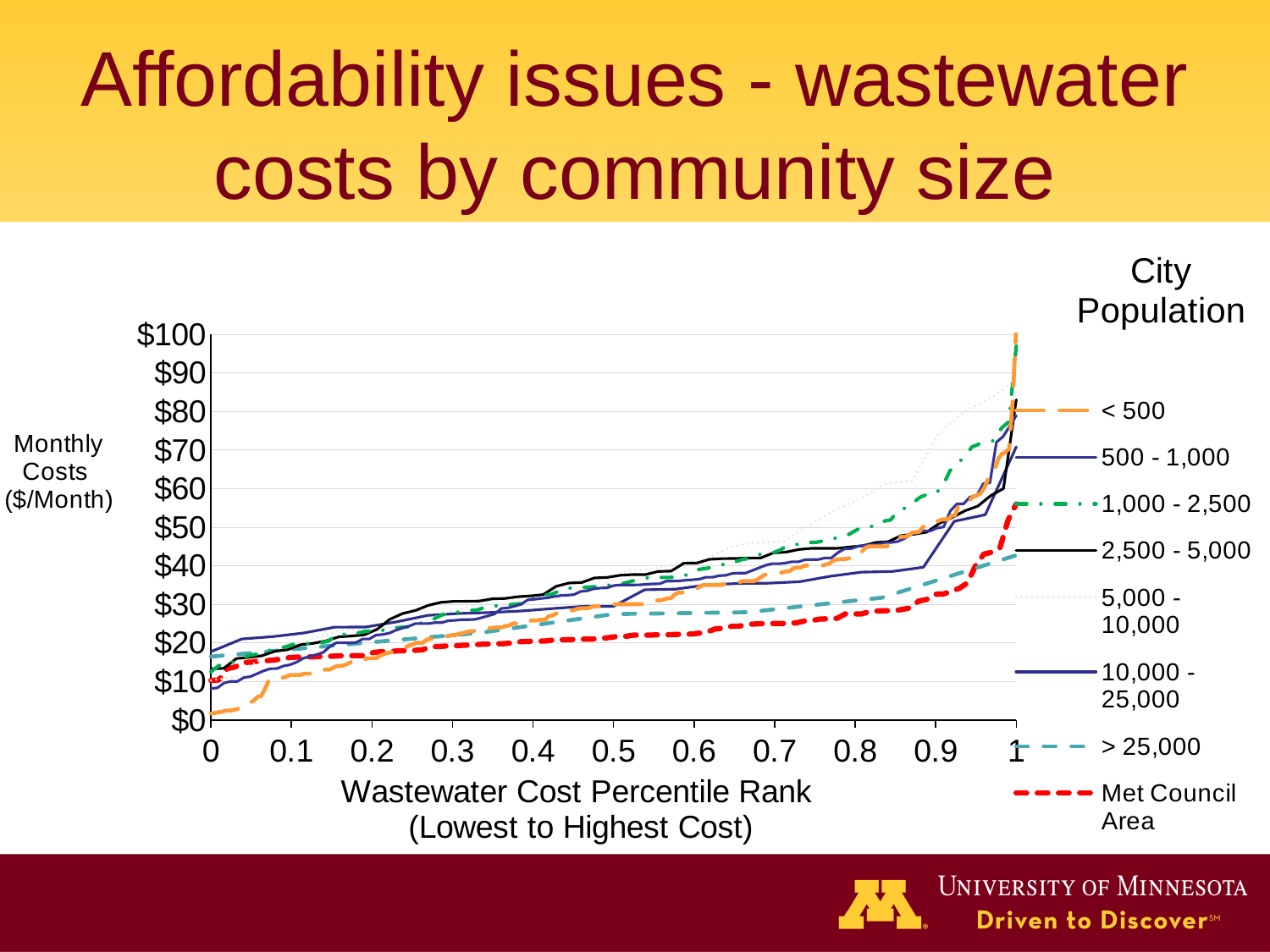
Do the lines rise or fall as the percentile rank increases along the x axis? rise At percentile rank 0.5, which is larger: the Met Council Area or the 2,500 - 5,000 series? 2,500 - 5,000 Is the value for the Met Council Area at percentile rank 0.5 greater or less than $30? less How many series does the legend list? 8 At percentile rank 0.9, which is larger: the 1,000 - 2,500 series or the Met Council Area? 1,000 - 2,500 What kind of chart is shown on the slide? line chart Is the value for the 2,500 - 5,000 series at percentile rank 0.3 greater or less than $20? greater Is the value for the > 25,000 series at percentile rank 0.9 greater or less than $50? less Which series has the lowest value at percentile rank 0.5? Met Council Area What is the label of the x axis? Wastewater Cost Percentile Rank (Lowest to Highest Cost) What is the title of the legend? City Population